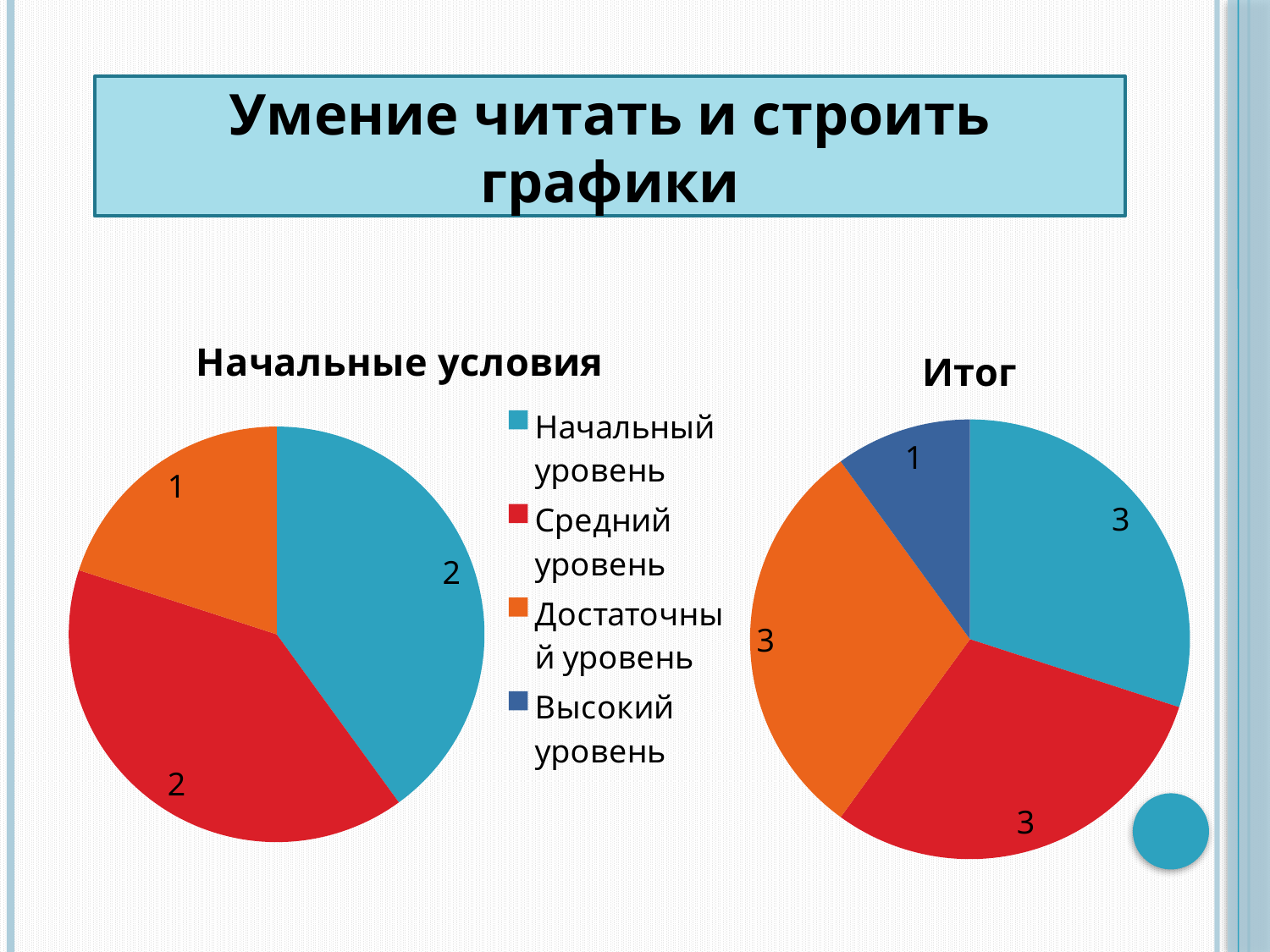
How many slices does the 'Итог' pie chart have? 4 In the 'Начальные условия' chart, what is the value for Достаточный уровень? 1 In the 'Итог' chart, what share of the total does Высокий уровень represent? 10% What kind of chart is the 'Начальные условия' chart? pie chart In the 'Итог' chart, what is the value for Высокий уровень? 1 In the 'Итог' chart, what is the difference between the values for Средний уровень and Высокий уровень? 2 In the 'Итог' chart, which category has the smallest slice? Высокий уровень How many entries does the legend list? 4 In the 'Итог' chart, what is the value for Начальный уровень? 3 In the 'Начальные условия' chart, what is the value for Средний уровень? 2 In the 'Начальные условия' chart, which category has the smallest slice? Достаточный уровень In the 'Начальные условия' chart, which is larger: the value for Начальный уровень or Достаточный уровень? Начальный уровень